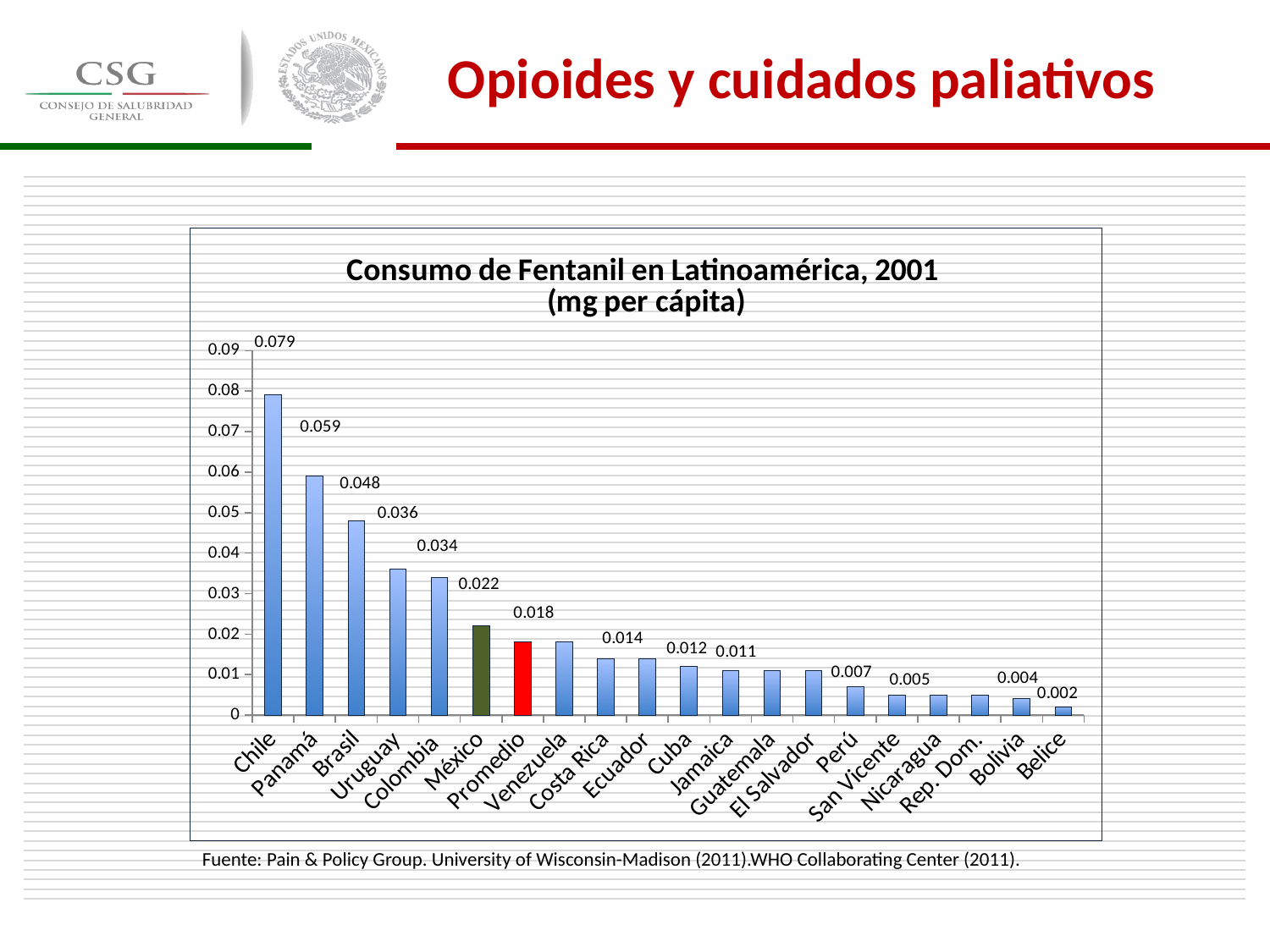
What kind of chart is shown on the slide? bar chart How many categories are shown on the x axis of the chart? 20 What is the value shown for Belice? 0.002 What is the fentanyl consumption value for Chile? 0.079 Which has a larger value, Brasil or Uruguay? Brasil What is the difference between the values for México and Promedio? 0.004 Which country has the lowest fentanyl consumption in the chart? Belice Which country has the highest fentanyl consumption in the chart? Chile What is the value shown for Promedio? 0.018 What is the fentanyl consumption value for México? 0.022 Is the value for Ecuador greater or less than 0.02? less What is the difference between the values for Chile and Panamá? 0.020